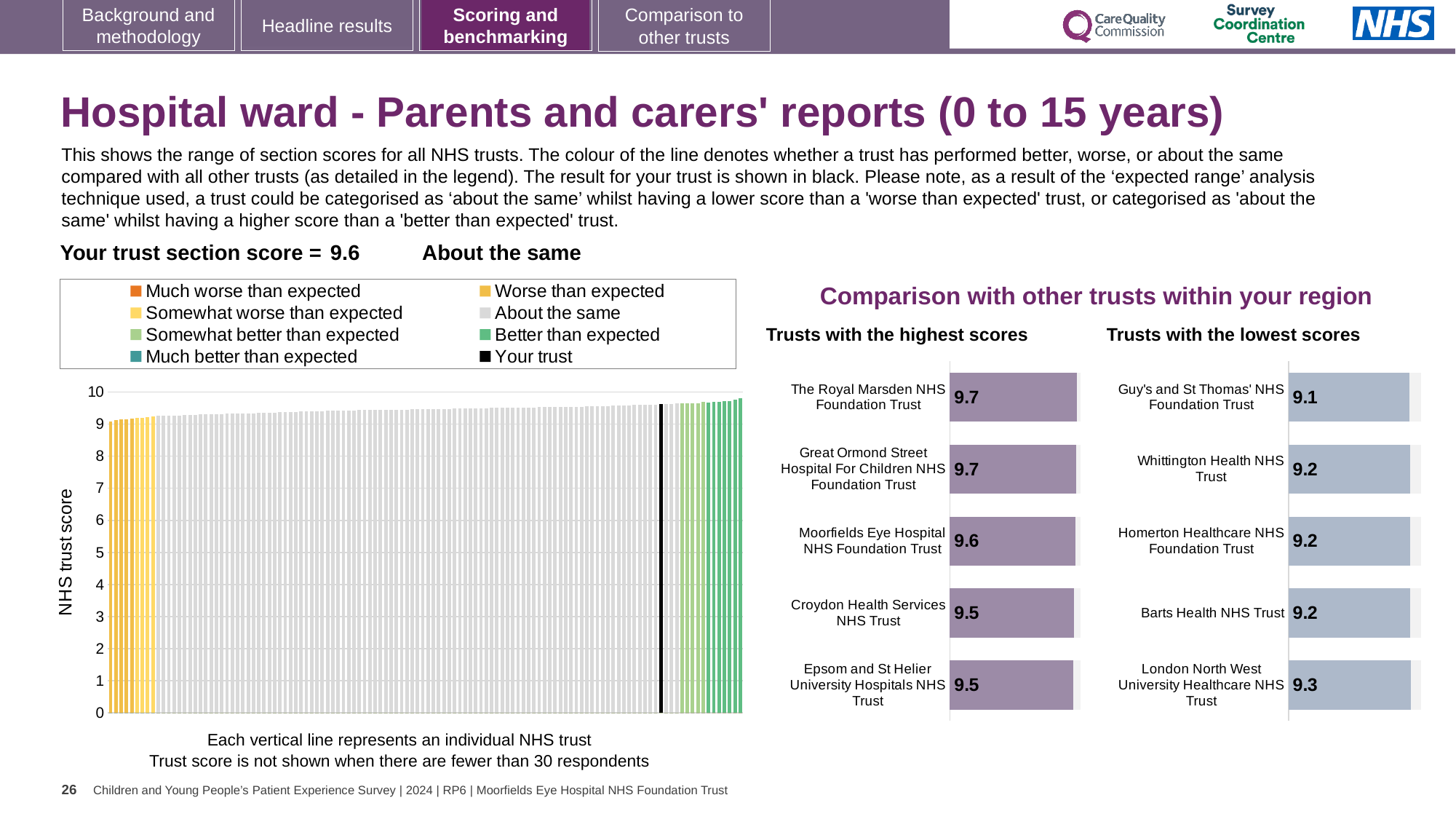
In the 'Trusts with the lowest scores' chart, which trust has the lowest score? Guy's and St Thomas' NHS Foundation Trust In the large chart on the left showing all NHS trusts, is the value for your trust (the black line) greater or less than 9? greater In the large chart on the left showing all NHS trusts, do the trust scores rise or fall from left to right along the x axis? rise In the 'Trusts with the highest scores' chart, what is the score for The Royal Marsden NHS Foundation Trust? 9.7 In the 'Trusts with the lowest scores' chart, which trust has the highest score? London North West University Healthcare NHS Trust In the 'Trusts with the lowest scores' chart, what is the difference between the scores of London North West University Healthcare NHS Trust and Guy's and St Thomas' NHS Foundation Trust? 0.2 How many trusts are listed in the 'Trusts with the highest scores' chart? 5 In the 'Trusts with the highest scores' chart, which has the larger score: Moorfields Eye Hospital NHS Foundation Trust or Croydon Health Services NHS Trust? Moorfields Eye Hospital NHS Foundation Trust In the 'Trusts with the highest scores' chart, what is the difference between the scores of The Royal Marsden NHS Foundation Trust and Croydon Health Services NHS Trust? 0.2 How many entries does the legend of the large chart on the left list? 8 In the 'Trusts with the highest scores' chart, what is the score for Croydon Health Services NHS Trust? 9.5 In the 'Trusts with the lowest scores' chart, what is the score for Guy's and St Thomas' NHS Foundation Trust? 9.1